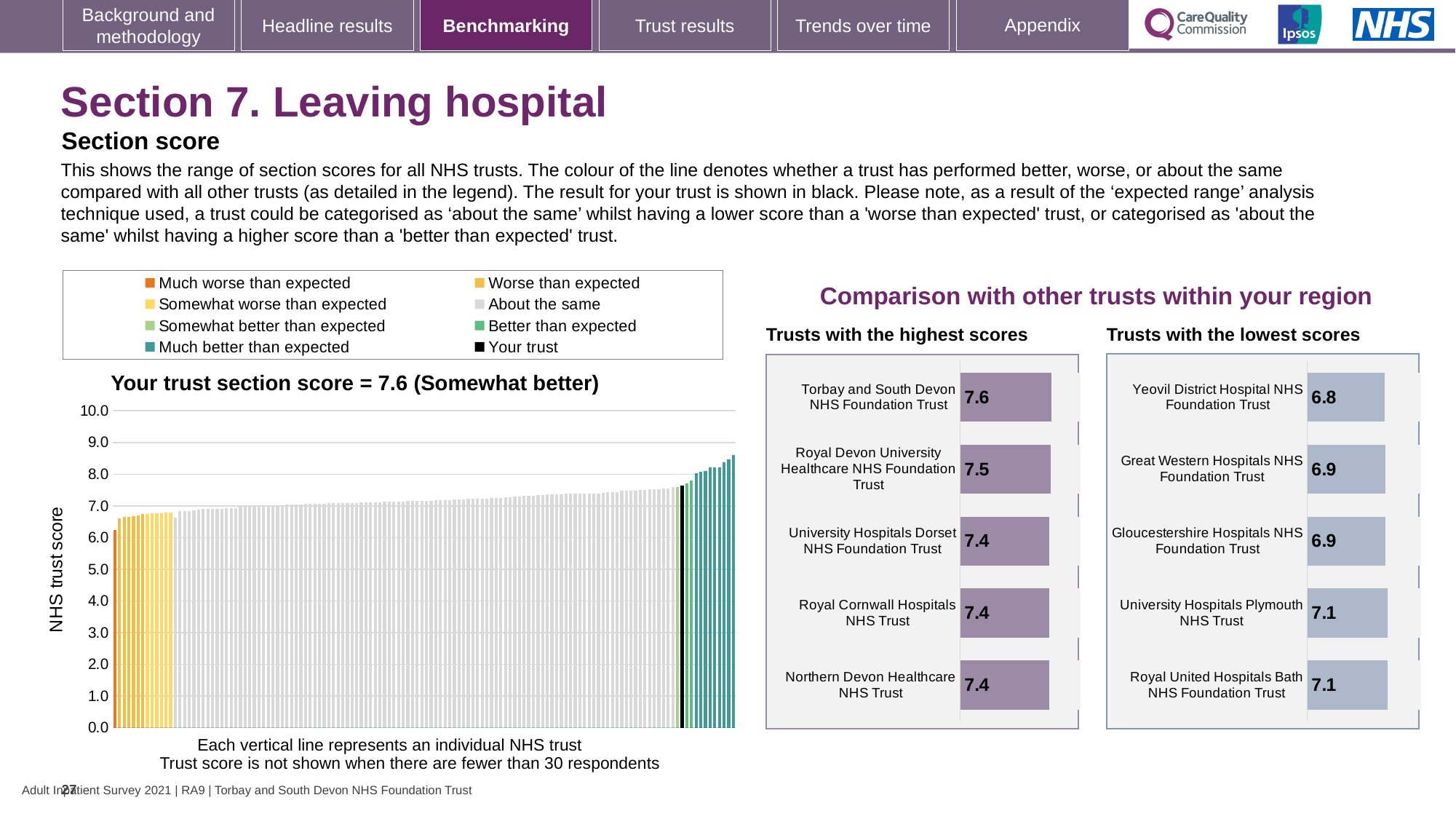
In the 'Trusts with the lowest scores' chart, what is the difference between the scores of University Hospitals Plymouth NHS Trust and Yeovil District Hospital NHS Foundation Trust? 0.3 What kind of chart is the 'Trusts with the lowest scores' chart? Bar chart In the 'Trusts with the highest scores' chart, what is the score for Torbay and South Devon NHS Foundation Trust? 7.6 In the 'Trusts with the lowest scores' chart, what is the score for Yeovil District Hospital NHS Foundation Trust? 6.8 According to the title of the chart on the left, what is your trust's section score? 7.6 (Somewhat better) In the 'Your trust section score' chart, is the value for your trust (the black bar) greater or less than 7.0? greater How many trusts are shown in the 'Trusts with the highest scores' chart? 5 In the 'Trusts with the highest scores' chart, what is the difference between the scores of Torbay and South Devon NHS Foundation Trust and Royal Devon University Healthcare NHS Foundation Trust? 0.1 In the 'Trusts with the lowest scores' chart, which has the larger score: Great Western Hospitals NHS Foundation Trust or University Hospitals Plymouth NHS Trust? University Hospitals Plymouth NHS Trust In the 'Trusts with the lowest scores' chart, which trust has the lowest score? Yeovil District Hospital NHS Foundation Trust In the 'Trusts with the highest scores' chart, what is the score for Royal Cornwall Hospitals NHS Trust? 7.4 In the 'Trusts with the highest scores' chart, which trust has the highest score? Torbay and South Devon NHS Foundation Trust